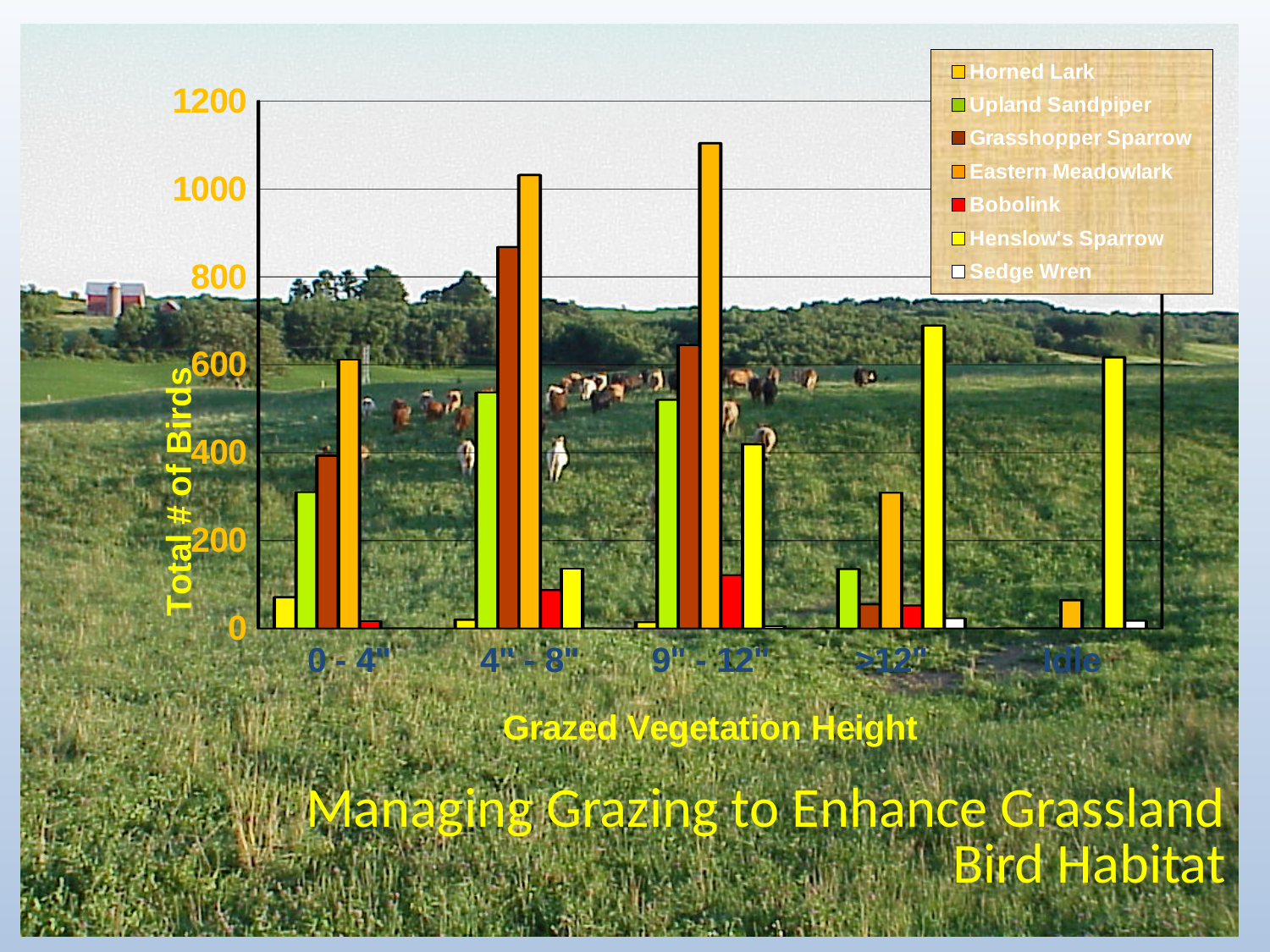
Which bird species has the tallest bar in the 4" - 8" category? Eastern Meadowlark Do the Henslow's Sparrow values rise or fall from 0 - 4" to >12"? rise What kind of chart is shown on the slide? bar chart How many vegetation height categories are shown on the x axis? 5 How many bird species does the legend list? 7 Which is larger, the Grasshopper Sparrow value for 4" - 8" or for 9" - 12"? 4" - 8" Is the Eastern Meadowlark value for 9" - 12" greater or less than 1000? greater Is the Bobolink value for 9" - 12" greater or less than 200? less What is the title of the y axis? Total # of Birds Is the Henslow's Sparrow value for >12" greater or less than 600? greater Which vegetation height category has the tallest Eastern Meadowlark bar? 9" - 12"